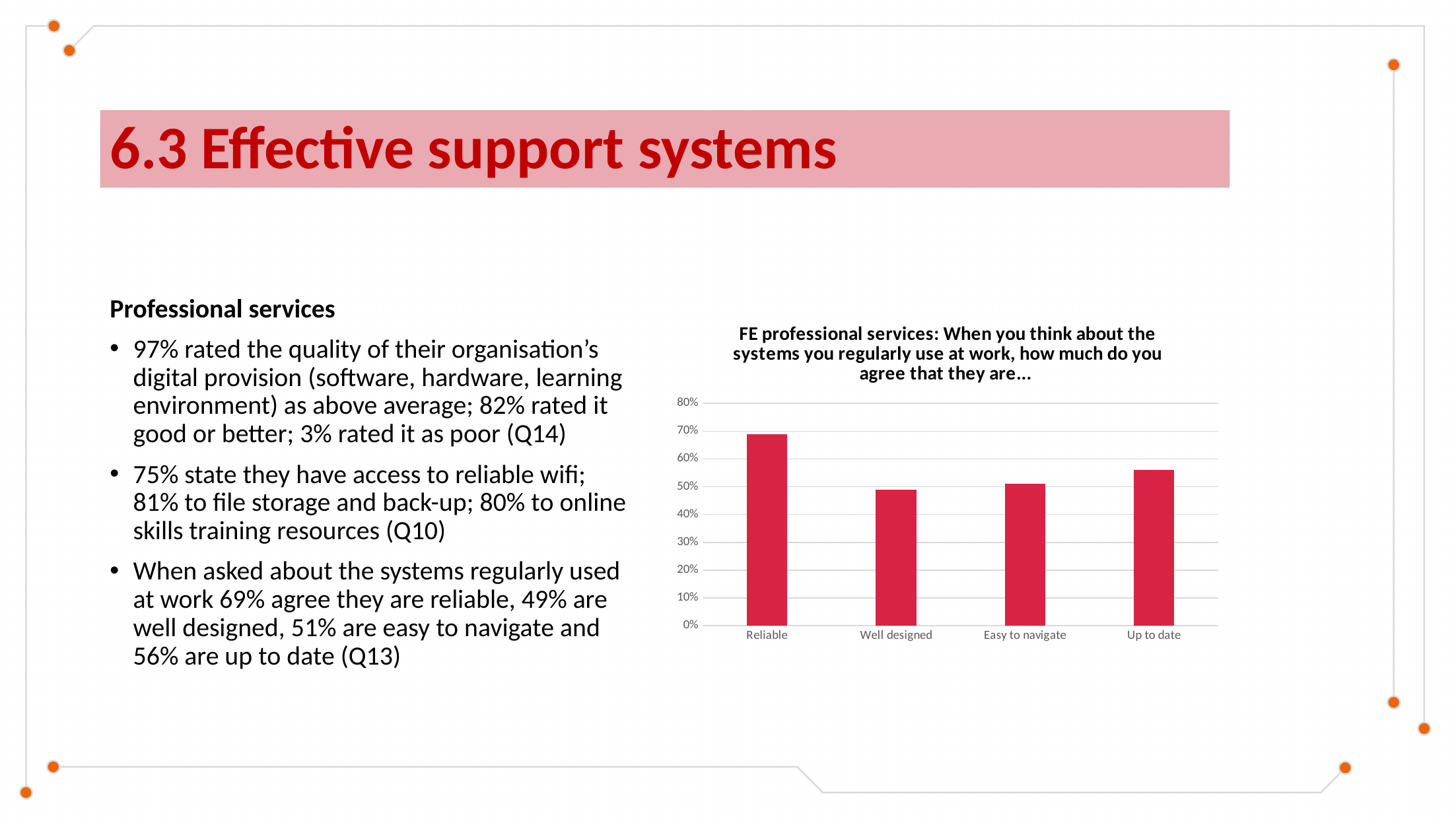
Which category has the highest bar in the chart? Reliable What is the label of the last category on the x axis of the chart? Up to date Is the value for Well designed greater or less than 60%? less What kind of chart is shown on the slide? bar chart Is the value for Easy to navigate greater or less than 40%? greater Which is larger, the value for Up to date or the value for Well designed? Up to date How many categories are shown on the x axis of the chart? 4 Which is larger, the value for Reliable or the value for Up to date? Reliable Is the value for Up to date greater or less than 60%? less What is the highest value shown on the y axis of the chart? 80%